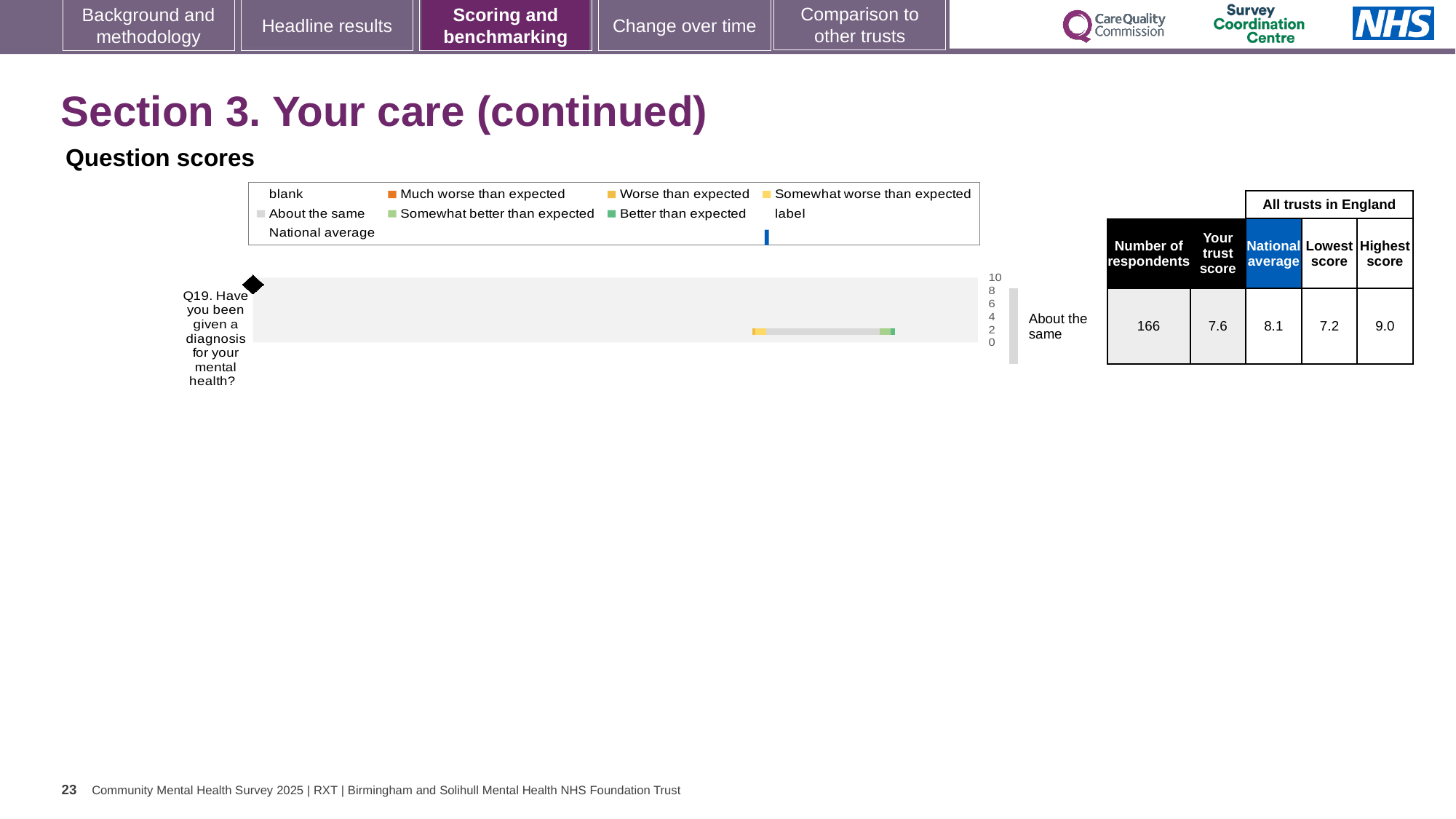
Which survey question is plotted on the chart? Q19. Have you been given a diagnosis for your mental health? How many survey questions are plotted on the chart? 1 What is the difference between the highest and lowest trust scores for Q19? 1.8 What is the lowest score among all trusts in England for Q19? 7.2 How many respondents answered Q19? 166 What is the trust score for Q19? 7.6 What is the highest score among all trusts in England for Q19? 9.0 What benchmark category is the trust's Q19 score placed in? About the same What is the maximum value shown on the chart's score axis? 10 What type of chart is used to show the Q19 question score? bar chart What is the national average score for Q19? 8.1 Which is larger for Q19, the trust score or the national average? national average